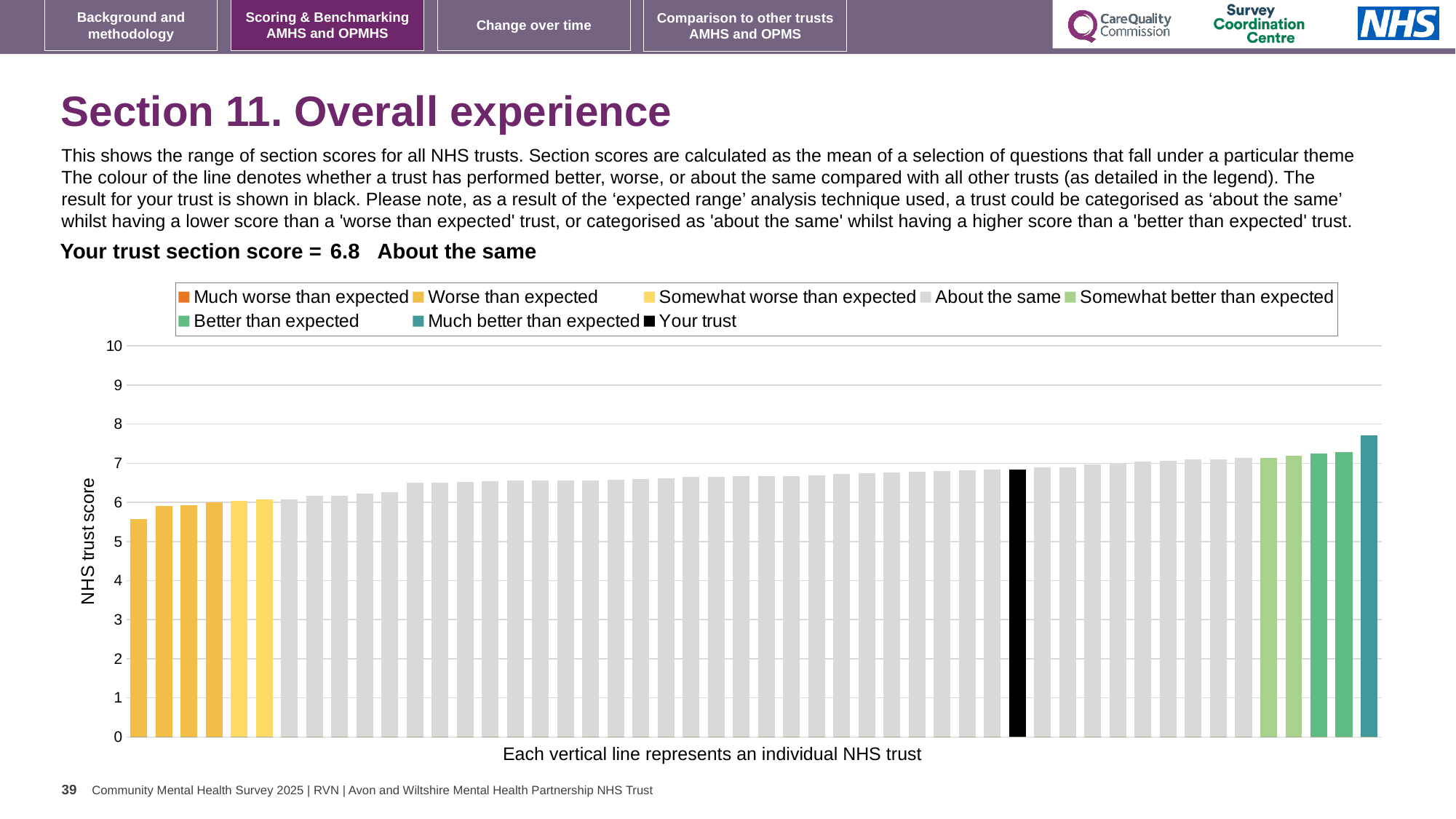
What colour is the bar representing your trust? black Is the value for your trust's bar greater or less than 6? greater Is the value of the tallest bar in the chart greater or less than 7? greater Is the value of the lowest bar in the chart greater or less than 6? less Which legend category does the tallest bar in the chart belong to? Much better than expected Which category is your trust's section score placed in? About the same What is the label on the vertical axis of the chart? NHS trust score What is the section score for your trust shown on the slide? 6.8 How many entries does the chart legend list? 8 How many bars are coloured as 'Much better than expected'? 1 What kind of chart is shown on the slide? bar chart